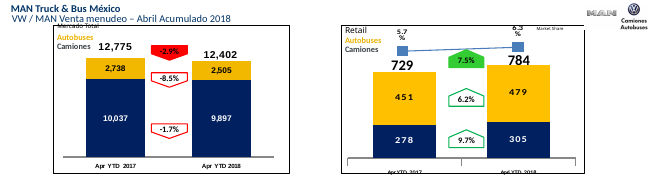
In the Retail chart on the right, what is the Autobuses value for Apr YTD 2018? 479 In the Mercado Total chart on the left, what is the Camiones value for Apr YTD 2018? 9,897 In the Retail chart on the right, what is the market share shown for Apr YTD 2018? 6.3% In the Mercado Total chart on the left, what is the difference between the Autobuses values for Apr YTD 2017 and Apr YTD 2018? 233 In the Retail chart on the right, which period has the larger total, Apr YTD 2017 or Apr YTD 2018? Apr YTD 2018 In the Mercado Total chart on the left, does the total rise or fall from Apr YTD 2017 to Apr YTD 2018? fall In the Retail chart on the right, what is the total value for Apr YTD 2018? 784 In the Retail chart on the right, what is the difference between the Camiones values for Apr YTD 2018 and Apr YTD 2017? 27 In the Mercado Total chart on the left, what is the total value for Apr YTD 2017? 12,775 In the Retail chart on the right, what is the Camiones value for Apr YTD 2017? 278 What kind of chart is the Mercado Total chart on the left? stacked bar chart In the Mercado Total chart on the left, what is the Autobuses value for Apr YTD 2017? 2,738